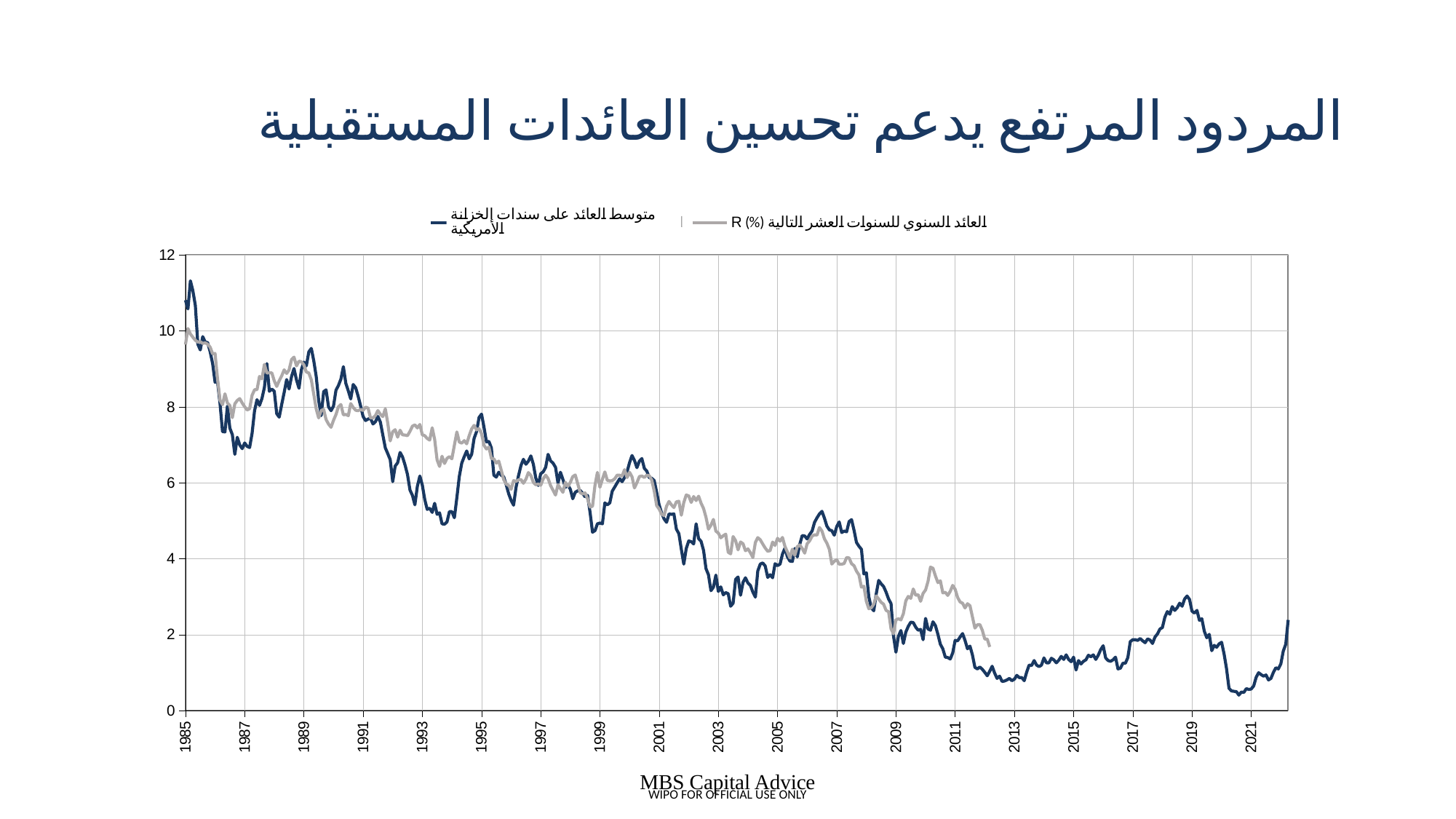
What kind of chart is shown on the slide? line chart How many year labels are shown on the x axis? 19 Around 2007, which line is higher: the dark blue line (متوسط العائد على سندات الخزانة الأمريكية) or the grey line (العائد السنوي للسنوات العشر التالية R (%))? the dark blue line (متوسط العائد على سندات الخزانة الأمريكية) How many series does the legend list? 2 What is the highest value shown on the y axis? 12 Is the final value of the grey line (العائد السنوي للسنوات العشر التالية R (%)) around 2012 greater or less than 4? less Is the value of the dark blue line (متوسط العائد على سندات الخزانة الأمريكية) around 2013 greater or less than 2? less Is the value of the grey line (العائد السنوي للسنوات العشر التالية R (%)) around 1989 greater or less than 8? greater Around 2003, which line is higher: the dark blue line (متوسط العائد على سندات الخزانة الأمريكية) or the grey line (العائد السنوي للسنوات العشر التالية R (%))? the grey line (العائد السنوي للسنوات العشر التالية R (%)) Overall, do the values of the dark blue line (متوسط العائد على سندات الخزانة الأمريكية) rise or fall from 1985 to 2021? fall